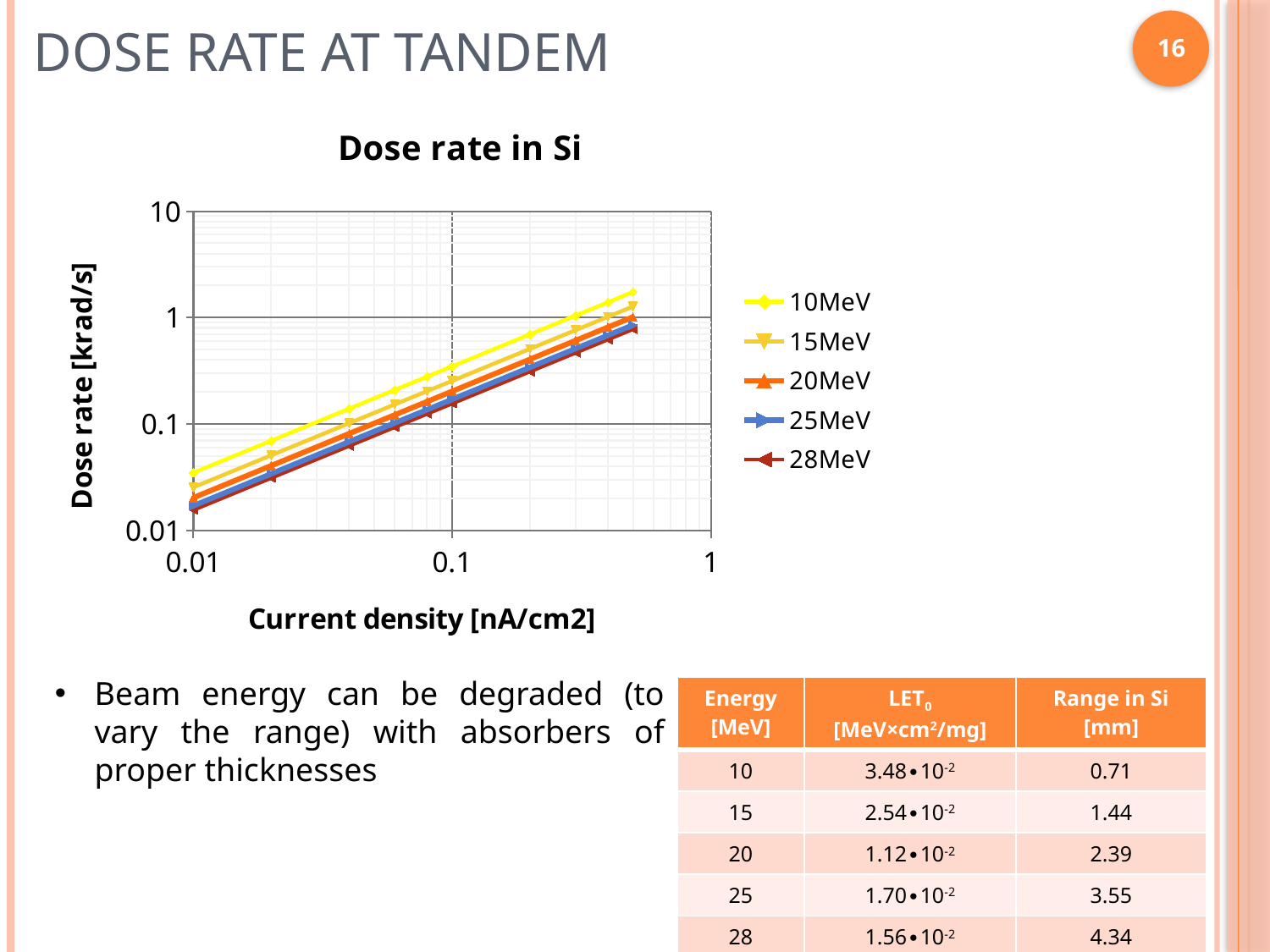
Which series has the highest dose rate across the plotted current densities? 10MeV At a current density of 0.1 nA/cm2, is the dose rate for the 28MeV series greater or less than 1 krad/s? less At a current density of 0.1 nA/cm2, which series has the larger dose rate, 10MeV or 28MeV? 10MeV At a current density of 0.1 nA/cm2, is the dose rate for the 10MeV series greater or less than 0.1 krad/s? greater How many series does the legend of the 'Dose rate in Si' chart list? 5 What kind of chart is the 'Dose rate in Si' chart? line chart What is the label of the y axis of the chart? Dose rate [krad/s] What is the title of the chart on the slide? Dose rate in Si At a current density of 0.01 nA/cm2, is the dose rate for the 10MeV series greater or less than 0.1 krad/s? less Which series has the larger dose rate at a current density of 0.01 nA/cm2, 15MeV or 20MeV? 15MeV Does the dose rate for the 10MeV series rise or fall as current density increases along the x axis? rise